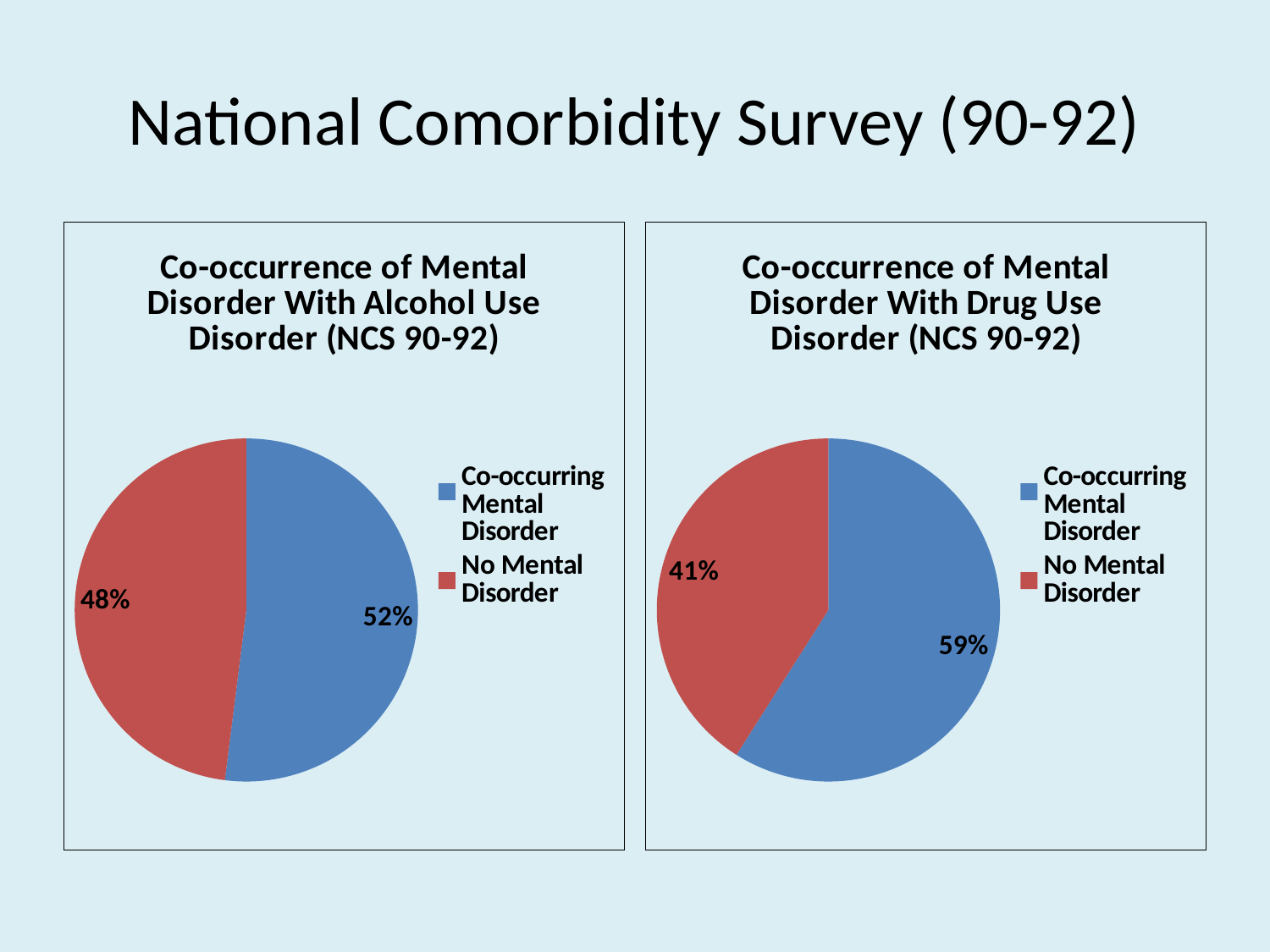
In the right chart (Co-occurrence of Mental Disorder With Drug Use Disorder), which slice is the largest? Co-occurring Mental Disorder In the left chart (Co-occurrence of Mental Disorder With Alcohol Use Disorder), what colour is the No Mental Disorder slice? Red In the right chart (Co-occurrence of Mental Disorder With Drug Use Disorder), what is the difference in percentage points between the Co-occurring Mental Disorder slice and the No Mental Disorder slice? 18 percentage points In the left chart (Co-occurrence of Mental Disorder With Alcohol Use Disorder), what share of the pie is No Mental Disorder? 48% In the left chart (Co-occurrence of Mental Disorder With Alcohol Use Disorder), what share of the pie is Co-occurring Mental Disorder? 52% In the right chart (Co-occurrence of Mental Disorder With Drug Use Disorder), what share of the pie is No Mental Disorder? 41% In the left chart (Co-occurrence of Mental Disorder With Alcohol Use Disorder), what is the difference in percentage points between the Co-occurring Mental Disorder slice and the No Mental Disorder slice? 4 percentage points In the right chart (Co-occurrence of Mental Disorder With Drug Use Disorder), what share of the pie is Co-occurring Mental Disorder? 59% In the right chart (Co-occurrence of Mental Disorder With Drug Use Disorder), which slice is the smallest? No Mental Disorder Which chart has the larger Co-occurring Mental Disorder share: the left chart (Alcohol Use Disorder) or the right chart (Drug Use Disorder)? The right chart (Drug Use Disorder) How many slices does the right chart (Co-occurrence of Mental Disorder With Drug Use Disorder) have? 2 What type of chart is the left chart (Co-occurrence of Mental Disorder With Alcohol Use Disorder)? Pie chart